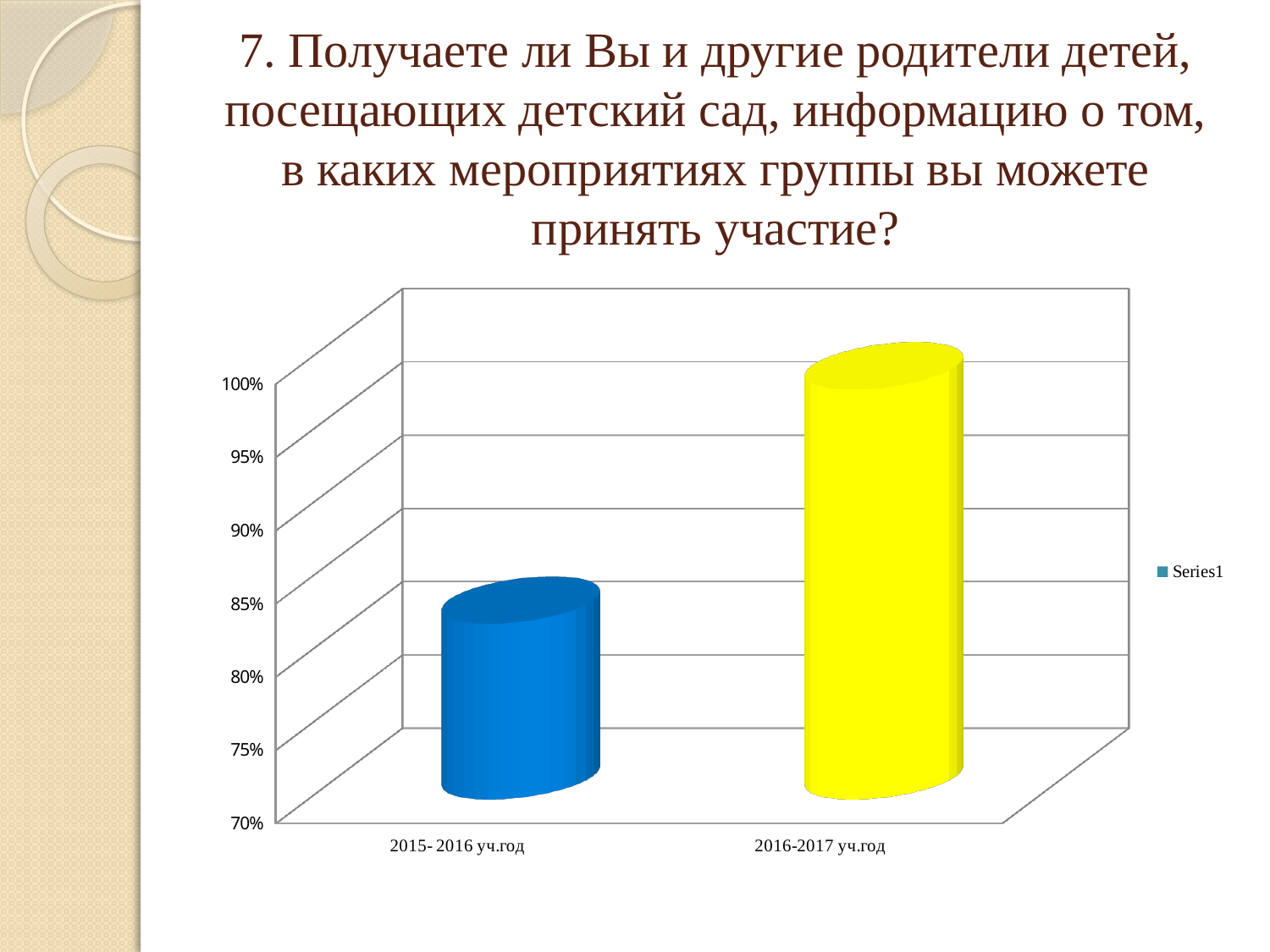
Which is larger: the value for 2015- 2016 уч.год or the value for 2016-2017 уч.год? 2016-2017 уч.год Is the value for 2015- 2016 уч.год greater or less than 90%? less How many series does the legend list? 1 Which category has the lowest value in the chart? 2015- 2016 уч.год How many categories are shown on the x axis of the chart? 2 Do the values rise or fall from 2015- 2016 уч.год to 2016-2017 уч.год? rise Is the value for 2015- 2016 уч.год greater or less than 80%? greater What is the name of the series shown in the legend? Series1 What colour is the bar for 2016-2017 уч.год? yellow Is the value for 2016-2017 уч.год greater or less than 95%? greater What kind of chart is shown on the slide? bar chart Which category has the highest value in the chart? 2016-2017 уч.год